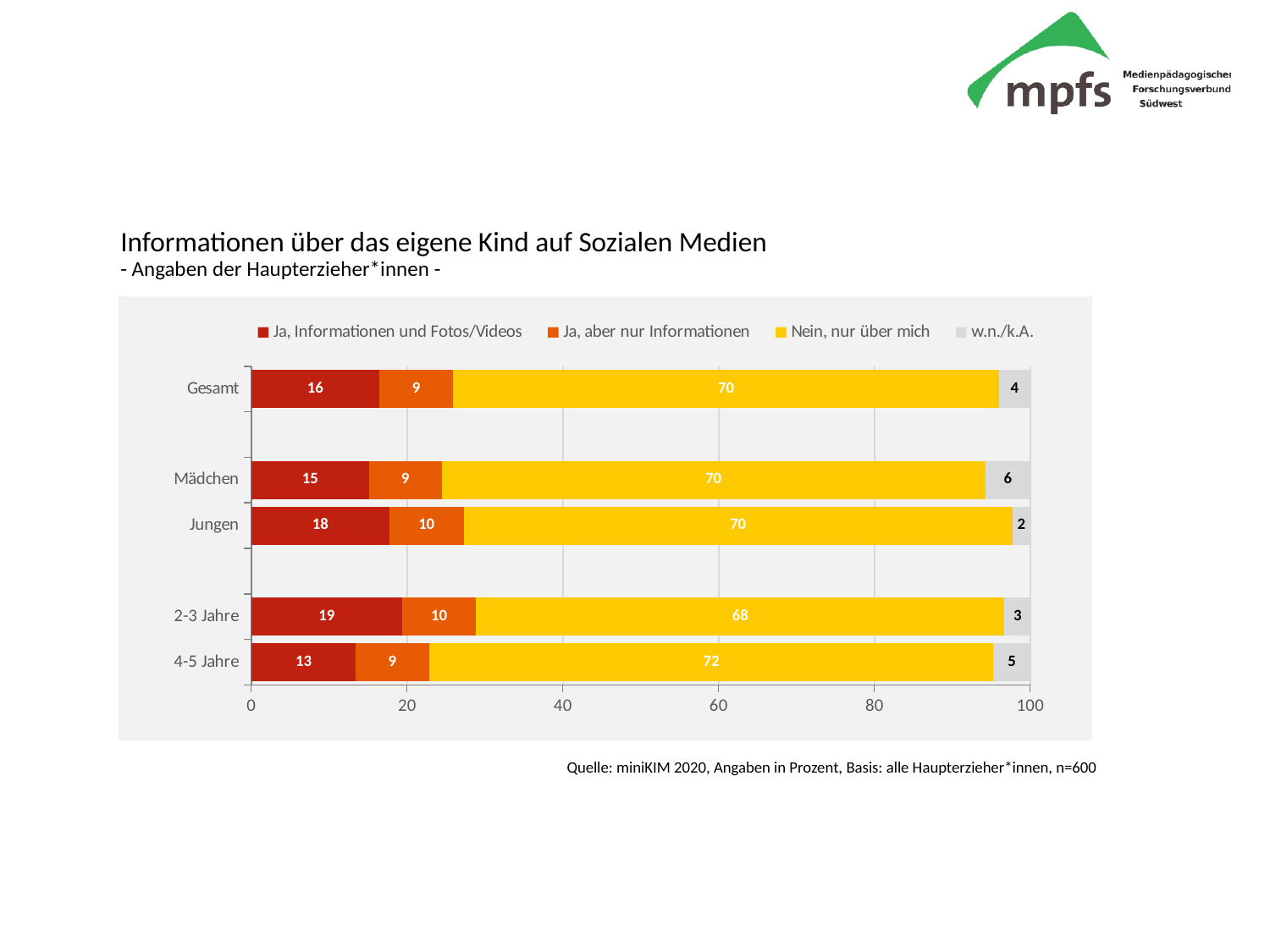
Which category has the lowest value for "w.n./k.A."? Jungen What is the title of the chart? Informationen über das eigene Kind auf Sozialen Medien Which is larger: the "Ja, aber nur Informationen" value for Jungen or for Mädchen? Jungen What kind of chart is shown on the slide? Stacked bar chart What is the difference between the "Ja, Informationen und Fotos/Videos" values for 2-3 Jahre and 4-5 Jahre? 6 How many categories are shown on the y axis? 5 What is the value for "Ja, Informationen und Fotos/Videos" for Gesamt? 16 Which category has the highest value for "Ja, Informationen und Fotos/Videos"? 2-3 Jahre What is the value for "w.n./k.A." for Mädchen? 6 How many series does the legend list? 4 What is the value for "Nein, nur über mich" for 4-5 Jahre? 72 What is the total of the stacked bar for Jungen? 100